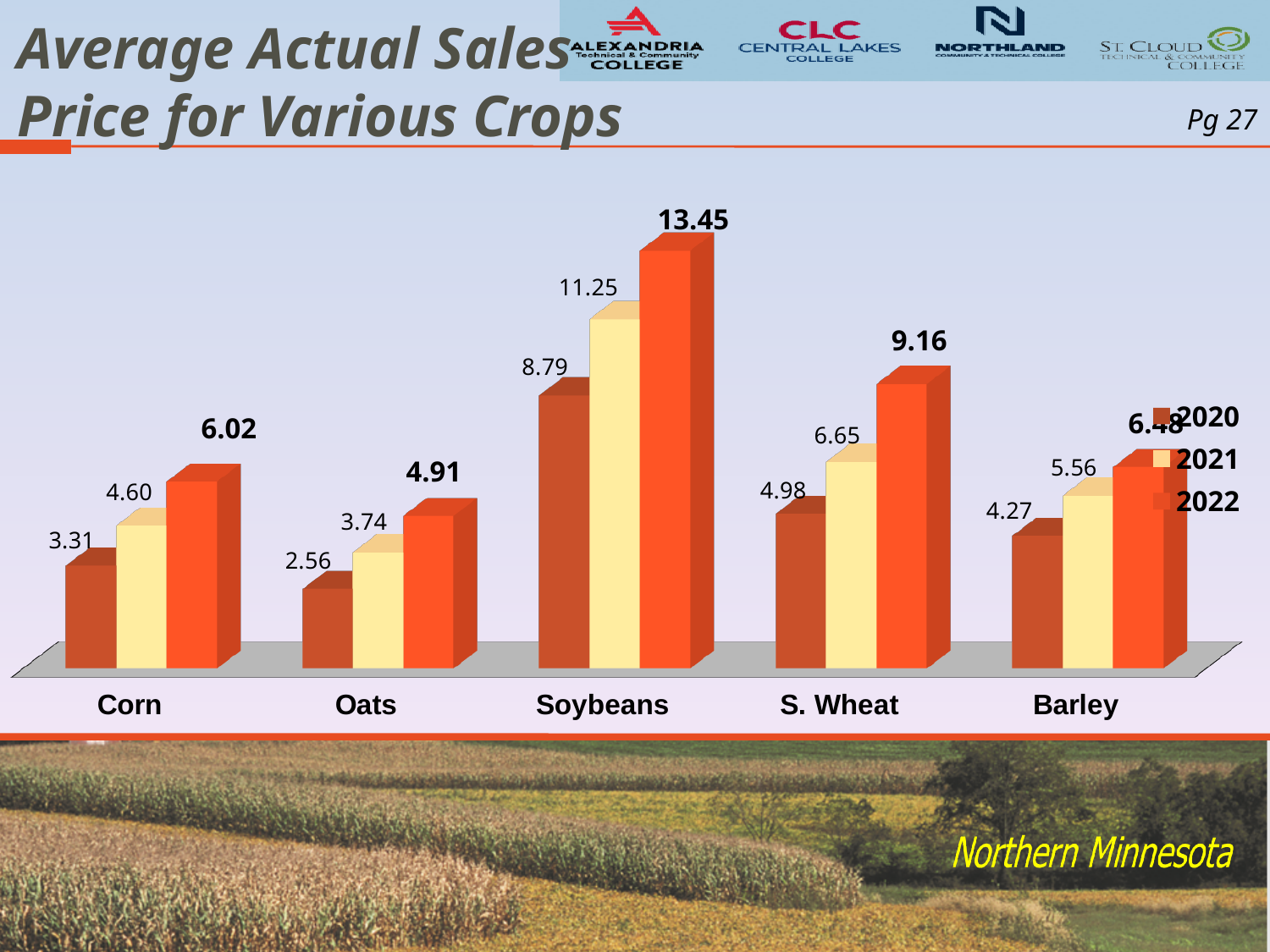
What is the 2021 value for S. Wheat? 6.65 Which crop has the lowest 2020 value? Oats What is the 2020 value for Corn? 3.31 How many series does the legend list? 3 Which crop has the highest 2022 value? Soybeans How many crops are shown on the x axis? 5 What is the difference between the 2022 and 2020 values for Soybeans? 4.66 Which is larger, the 2021 value for Corn or the 2021 value for Oats? Corn What kind of chart is shown on the slide? Bar chart What is the 2021 value for Barley? 5.56 What is the 2022 value for Soybeans? 13.45 What is the difference between the 2022 values for S. Wheat and Oats? 4.25